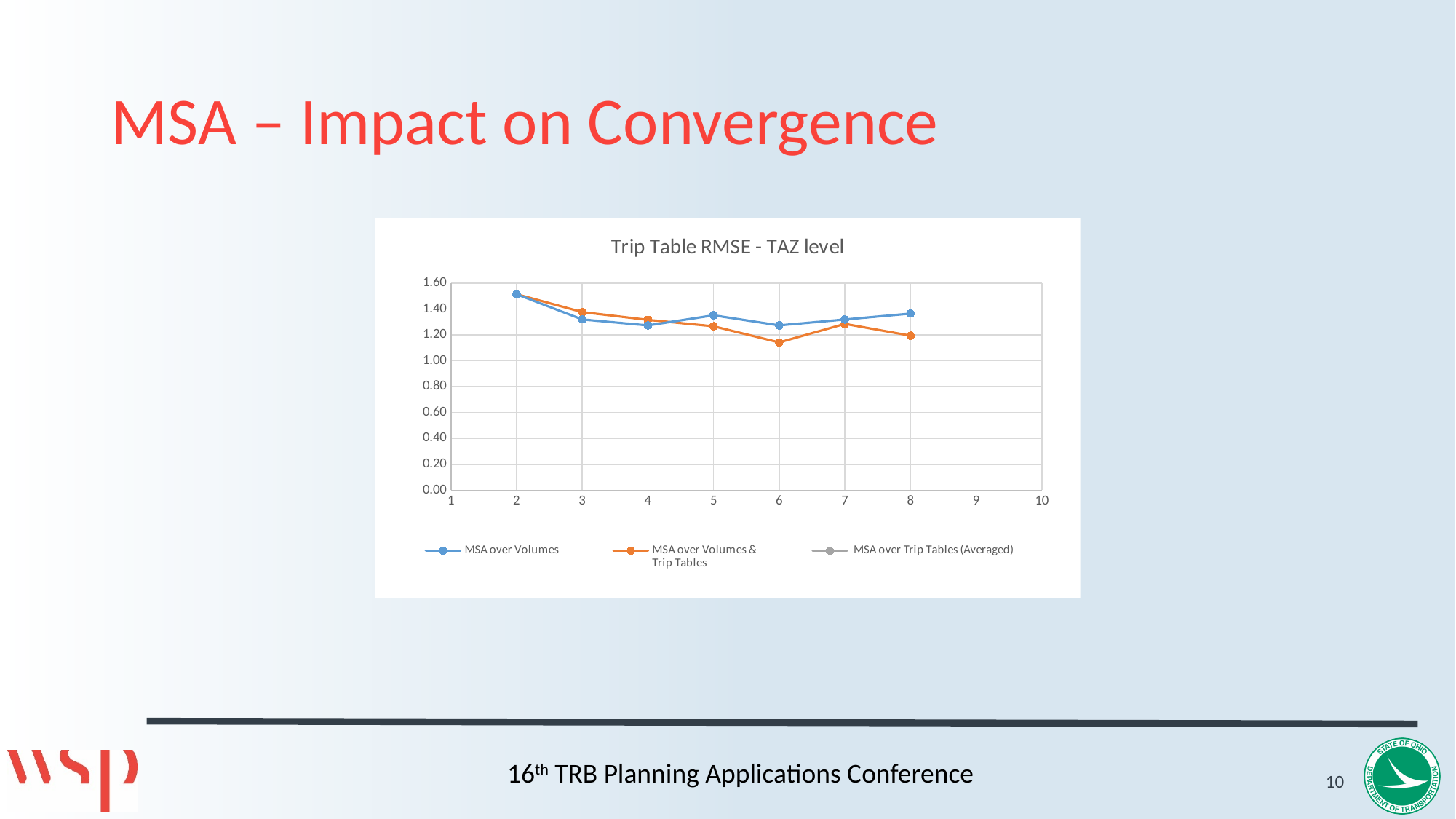
Is the value for MSA over Volumes at x = 2 greater or less than 1.40? greater What kind of chart is shown on the slide? line chart At which x value does the MSA over Volumes & Trip Tables series reach its lowest point? 6 Is the value for MSA over Volumes at x = 8 greater or less than 1.20? greater How many series does the chart legend list? 3 What is the title of the chart? Trip Table RMSE - TAZ level Is the value for MSA over Volumes & Trip Tables at x = 6 greater or less than 1.20? less Which series is drawn in orange? MSA over Volumes & Trip Tables How many data points are plotted for the MSA over Volumes series? 7 At x = 8, which series has the larger value, MSA over Volumes or MSA over Volumes & Trip Tables? MSA over Volumes Does the MSA over Volumes series rise or fall between x = 2 and x = 3? fall At x = 6, which series has the larger value, MSA over Volumes or MSA over Volumes & Trip Tables? MSA over Volumes